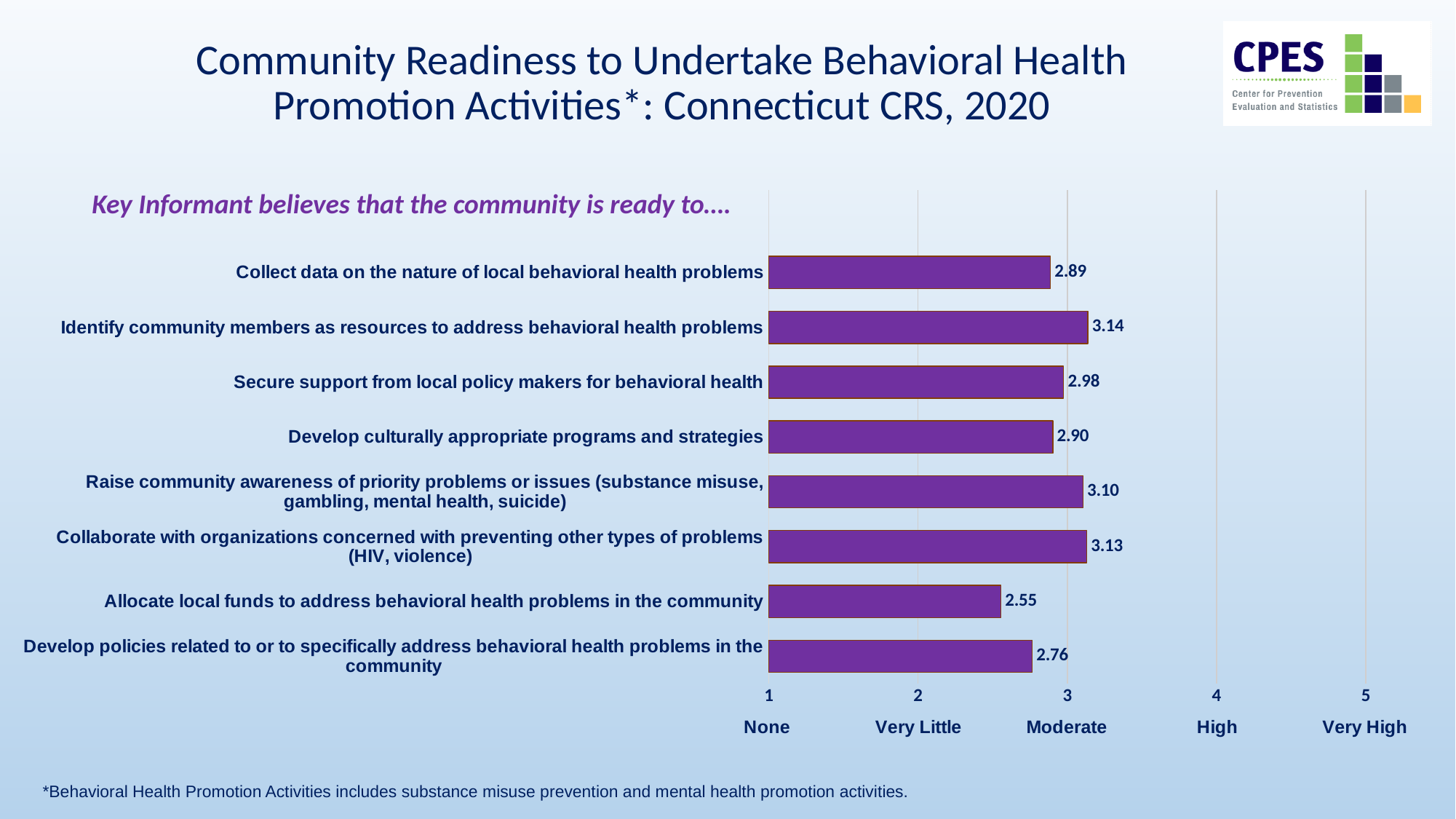
Which is larger: the value for "Develop culturally appropriate programs and strategies" or the value for "Develop policies related to or to specifically address behavioral health problems in the community"? Develop culturally appropriate programs and strategies What kind of chart is shown on the slide? bar chart What is the value for "Collect data on the nature of local behavioral health problems"? 2.89 Which category has the lowest value? Allocate local funds to address behavioral health problems in the community What is the value for "Allocate local funds to address behavioral health problems in the community"? 2.55 What is the difference between the values for "Identify community members as resources to address behavioral health problems" and "Allocate local funds to address behavioral health problems in the community"? 0.59 Is the value for "Raise community awareness of priority problems or issues (substance misuse, gambling, mental health, suicide)" greater or less than 3? greater What is the difference between the values for "Collaborate with organizations concerned with preventing other types of problems (HIV, violence)" and "Develop policies related to or to specifically address behavioral health problems in the community"? 0.37 How many categories are shown in the chart? 8 What is the value for "Secure support from local policy makers for behavioral health"? 2.98 Which category has the highest value? Identify community members as resources to address behavioral health problems What label on the x axis corresponds to the value 3? Moderate